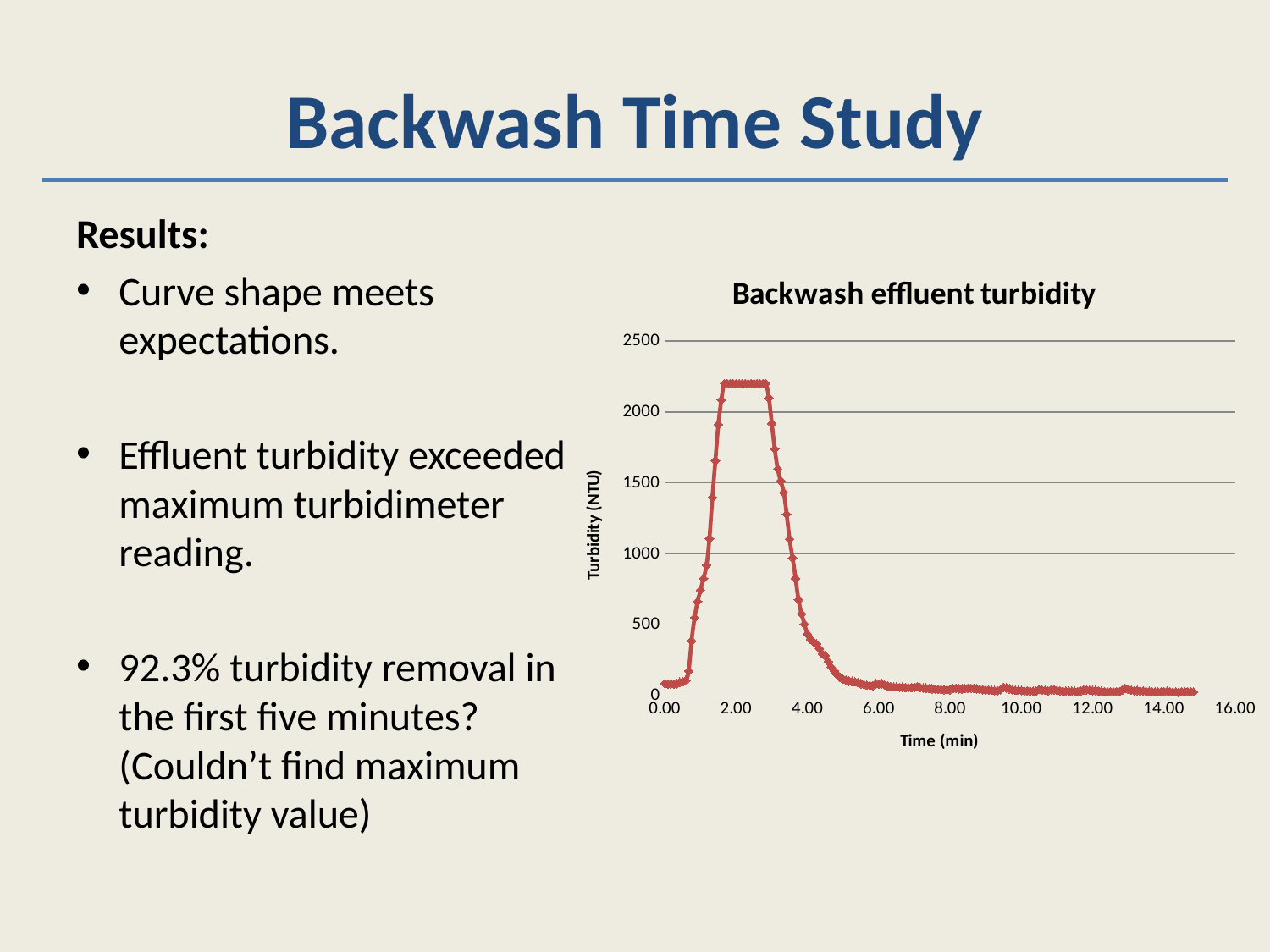
Is the turbidity value at 6.00 min greater or less than 500? less Does the turbidity rise or fall between 3.00 min and 5.00 min? fall What is the label of the y axis of the chart? Turbidity (NTU) Is the turbidity value at 8.00 min greater or less than 1000? less Which has the higher turbidity, the reading at 2.00 min or the reading at 6.00 min? 2.00 min Is the turbidity value at 10.00 min greater or less than 500? less What is the title of the chart? Backwash effluent turbidity What kind of chart is shown on the slide? line chart Which has the lower turbidity, the reading at 1.00 min or the reading at 2.00 min? 1.00 min Does the turbidity rise or fall between 1.00 min and 2.00 min? rise